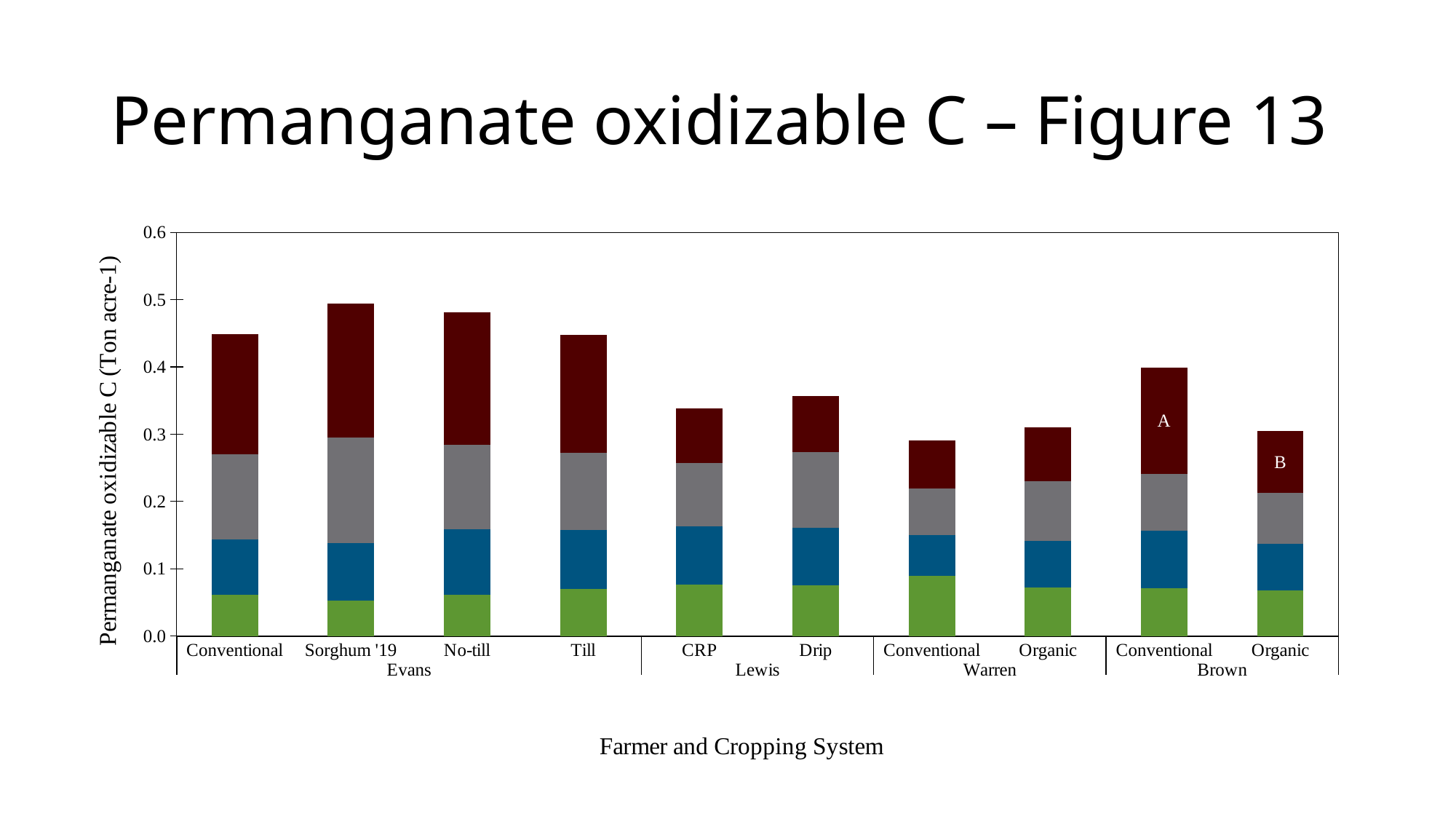
Is the total value for Evans Conventional greater or less than 0.5? less Which has the larger total value, Evans Till or Lewis CRP? Evans Till Which two bars are marked with the letters A and B? Brown Conventional (A) and Brown Organic (B) How many bars (farmer and cropping system combinations) are plotted in the chart? 10 What kind of chart is shown on the slide? Stacked bar chart How many farmer groups are labelled along the x axis? 4 Is the total value for Brown Conventional greater or less than 0.3? greater Which has the larger total value, Brown Conventional or Brown Organic? Brown Conventional Is the total value for Lewis Drip greater or less than 0.3? greater What is the title of the x axis? Farmer and Cropping System